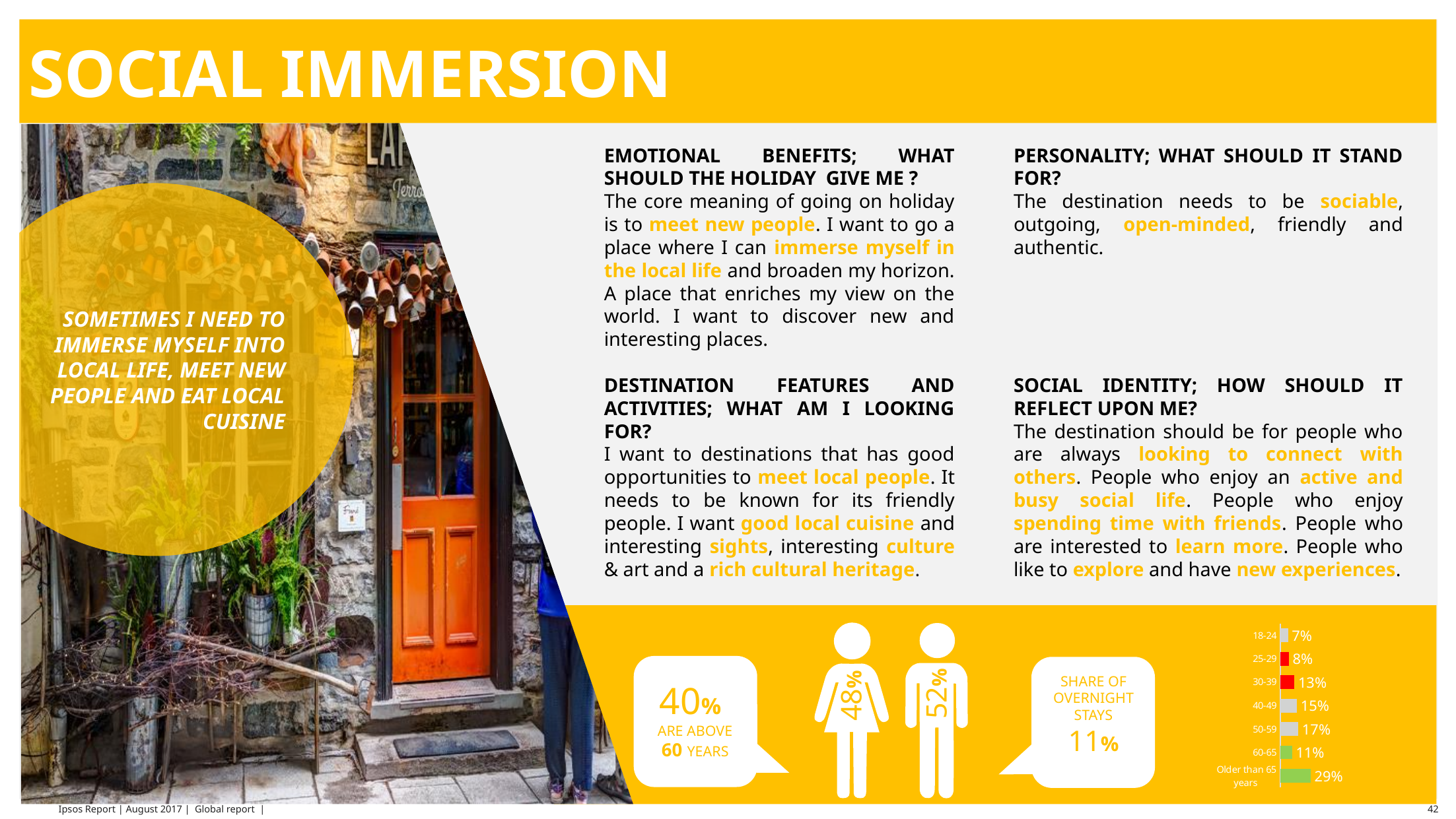
In the age-group bar chart at the bottom right, what is the combined value of the 60-65 and Older than 65 years groups? 40% In the age-group bar chart at the bottom right, what is the value for the 18-24 group? 7% In the age-group bar chart at the bottom right, what is the value for the Older than 65 years group? 29% What kind of chart is shown at the bottom right of the slide? Bar chart In the age-group bar chart at the bottom right, what is the value for the 30-39 group? 13% In the age-group bar chart at the bottom right, what is the value for the 50-59 group? 17% In the age-group bar chart at the bottom right, which age group has the highest value? Older than 65 years How many age groups are shown in the bar chart at the bottom right? 7 In the age-group bar chart at the bottom right, which is larger: the value for 60-65 or the value for 40-49? 40-49 In the age-group bar chart at the bottom right, what is the difference between the Older than 65 years group and the 50-59 group? 12% In the age-group bar chart at the bottom right, which age group has the lowest value? 18-24 In the age-group bar chart at the bottom right, what is the difference between the 40-49 group and the 25-29 group? 7%